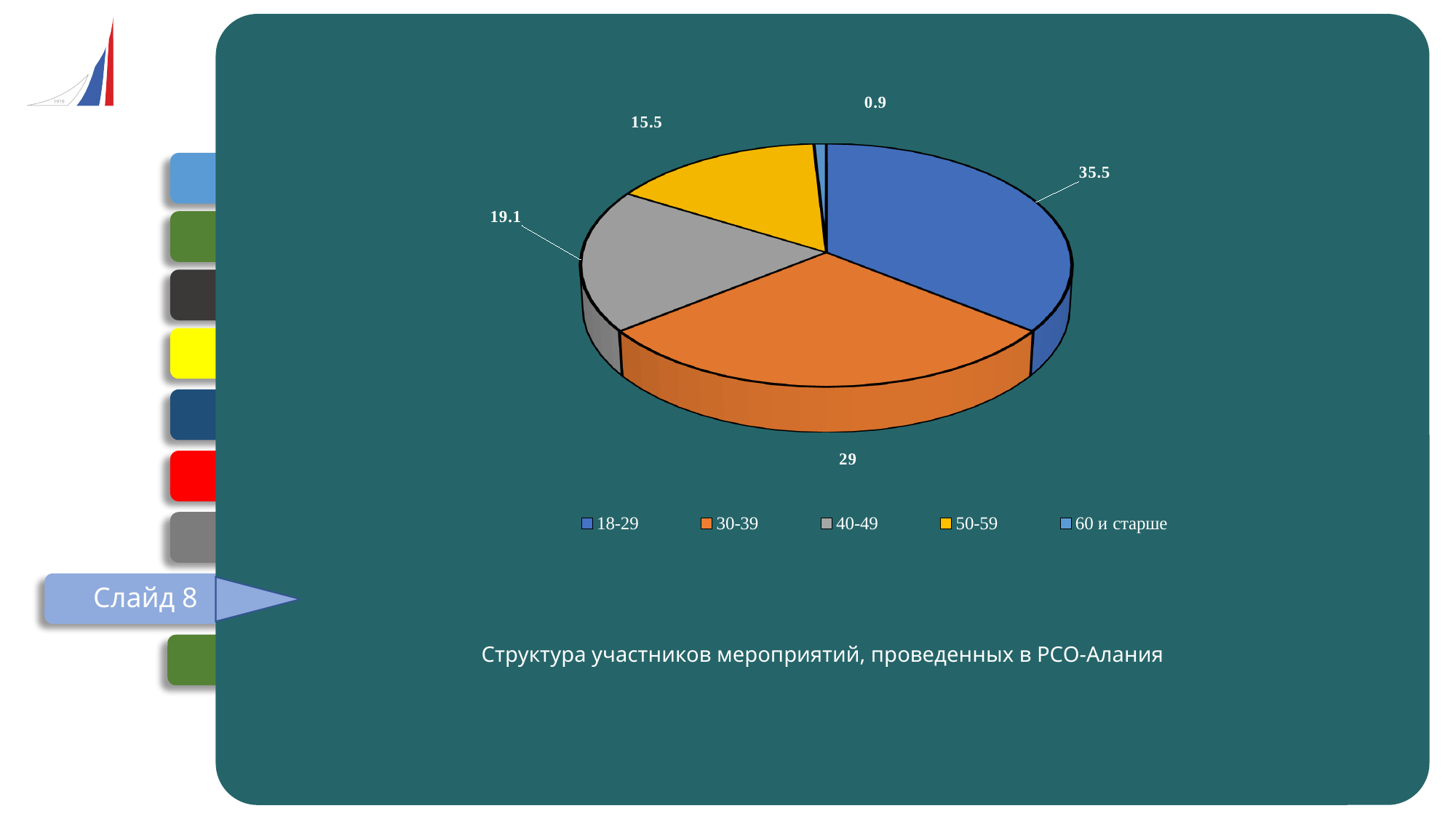
Which age group has the smallest slice of the pie? 60 и старше What is the title of the chart? Структура участников мероприятий, проведенных в РСО-Алания Which is larger, the value for 40-49 or the value for 50-59? 40-49 What is the value for the 40-49 age group? 19.1 What is the difference between the values for the 18-29 and 30-39 age groups? 6.5 How many age groups does the legend list? 5 Which age group has the largest slice of the pie? 18-29 What kind of chart is shown on the slide? pie chart What is the value for the '60 и старше' age group? 0.9 What is the value for the 30-39 age group? 29 What is the value for the 18-29 age group? 35.5 What is the value for the 50-59 age group? 15.5